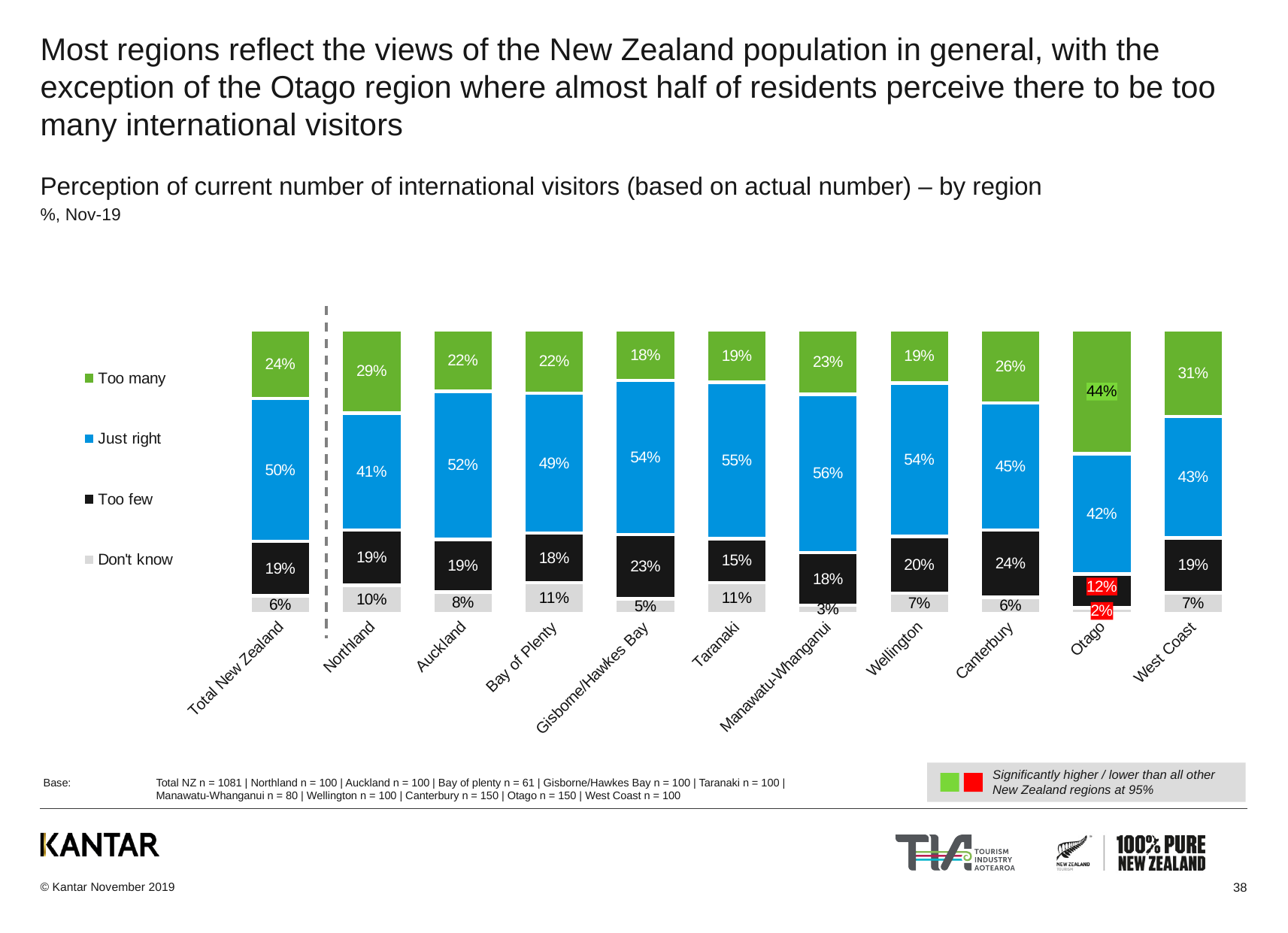
Which region has the highest 'Too many' percentage? Otago What percentage of Otago residents say there are too many international visitors? 44% How many regions (including Total New Zealand) are shown on the chart? 11 Which region has the lowest 'Don't know' percentage? Otago Which legend entry is shown in green? Too many What is the combined 'Too many' and 'Just right' percentage for Total New Zealand? 74% How many series does the legend list? 4 What is the 'Don't know' value for Bay of Plenty? 11% What kind of chart is shown on the slide? Stacked bar chart What is the difference between the 'Too few' values for Canterbury and Taranaki? 9% What is the 'Just right' value for Manawatu-Whanganui? 56% Which is larger, the 'Just right' value for Northland or for West Coast? West Coast